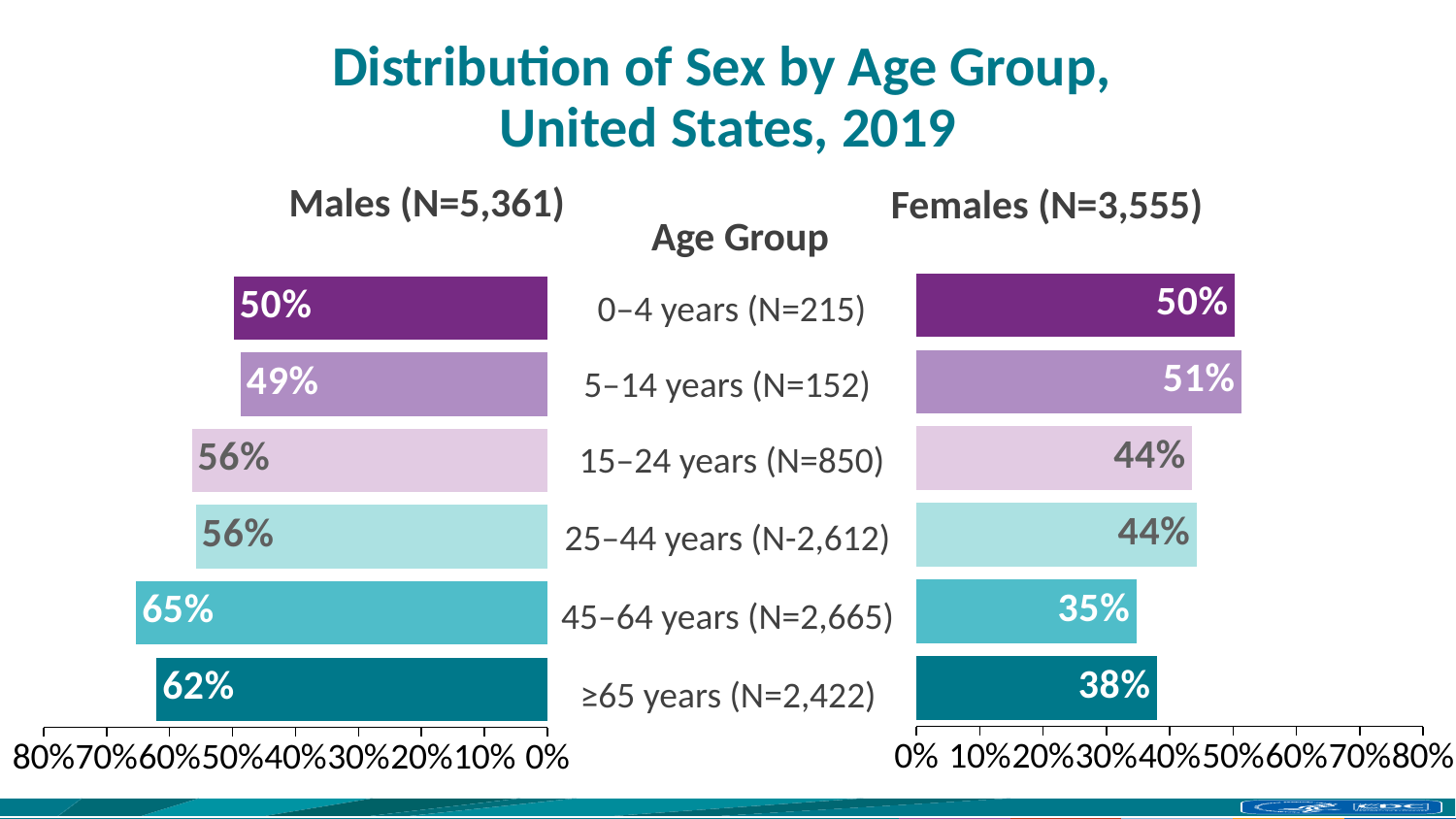
What type of chart is shown on the slide? Bar chart Which age group has the highest male percentage? 45–64 years What is the total sample size (N) for males shown in the chart? 5,361 What percentage of the 5–14 years age group is female? 51% What is the title of the chart? Distribution of Sex by Age Group, United States, 2019 For the 5–14 years age group, is the male or female percentage larger? Female Which age group has the lowest female percentage? 45–64 years What percentage of the ≥65 years age group is female? 38% What is the difference between the male percentages for the 45–64 years and 0–4 years age groups? 15% What percentage of the 45–64 years age group is male? 65% What is the difference between the male and female percentages for the ≥65 years age group? 24% How many age groups are shown in the chart? 6